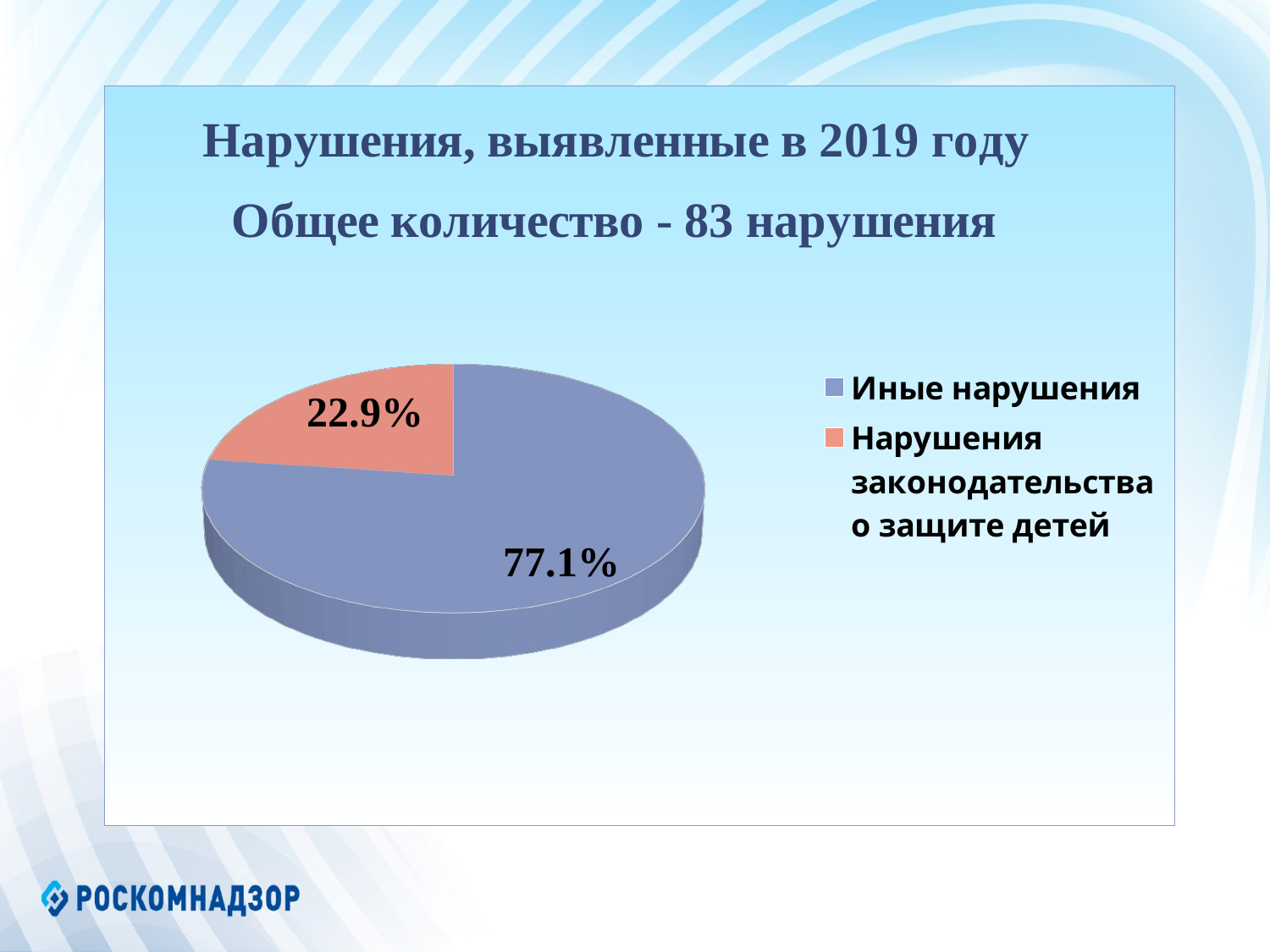
Which category has the smallest slice of the pie? Нарушения законодательства о защите детей What is the difference in percentage points between the slice for "Иные нарушения" and the slice for "Нарушения законодательства о защите детей"? 54.2 What share of the pie does the slice for "Иные нарушения" represent? 77.1% What share of the pie does the slice for "Нарушения законодательства о защите детей" represent? 22.9% Which category has the largest slice of the pie? Иные нарушения How many slices does the pie chart have? 2 What is the title of the chart? Общее количество - 83 нарушения What total number of violations does the slide state? 83 What kind of chart is shown on the slide? Pie chart How many entries does the legend list? 2 Which is larger: the slice for "Иные нарушения" or the slice for "Нарушения законодательства о защите детей"? Иные нарушения